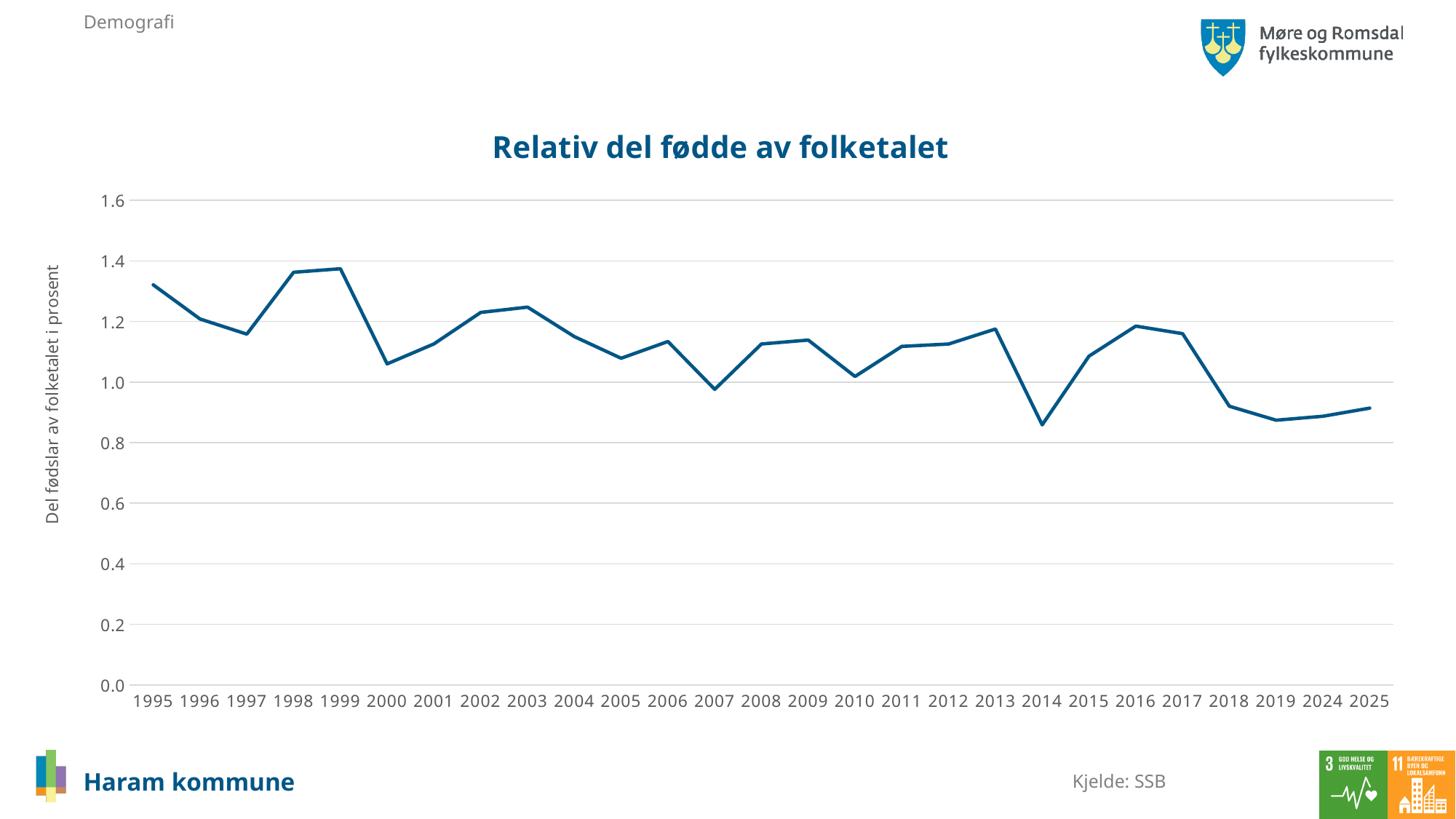
Overall, do the values rise or fall from 1995 to 2025? fall Is the value for 2016 greater or less than 1.0? greater How many years are plotted along the x axis of the chart? 27 What is the title of the chart? Relativ del fødde av folketalet What kind of chart is shown on the slide? line chart What is the label on the vertical axis of the chart? Del fødslar av folketalet i prosent Is the value for 2018 greater or less than 1.0? less Is the value for 1995 greater or less than 1.2? greater Which year has the larger value, 1995 or 2025? 1995 Which year has the larger value, 2013 or 2014? 2013